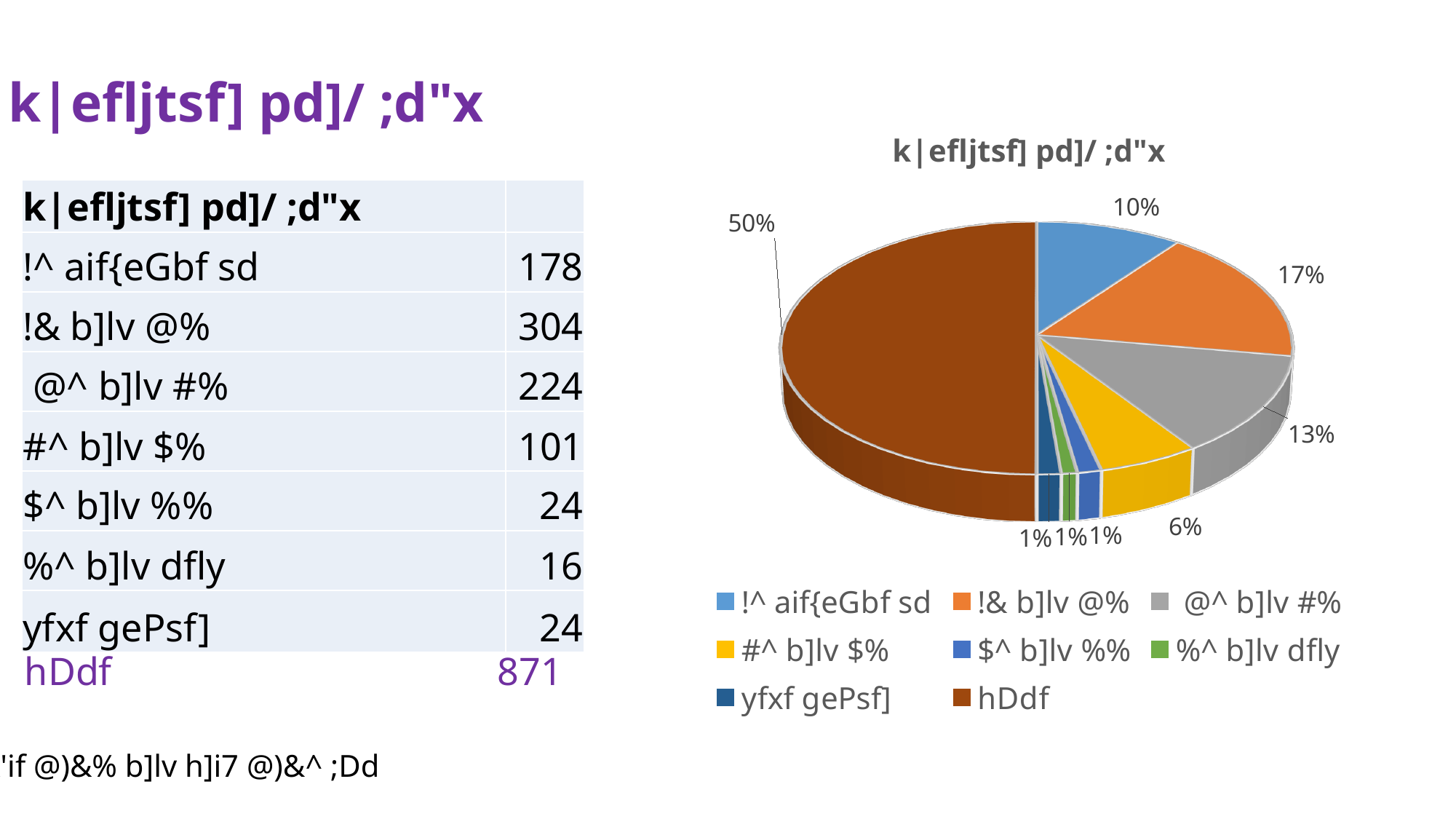
How many slices does the pie chart have? 8 What is the title of the pie chart? k|efljtsf] pd]/ ;d"x Which slice is larger in the pie chart, "!& b]lv @%" or "@^ b]lv #%"? !& b]lv @% Which slice of the pie chart is the largest? hDdf What percentage is shown for the hDdf slice of the pie chart? 50% What percentage is shown for the "!& b]lv @%" slice of the pie chart? 17% What percentage is shown for the "!^ aif{eGbf sd" slice of the pie chart? 10% What kind of chart is shown on the slide? pie chart How many entries does the legend of the pie chart list? 8 What is the difference in percentage points between the "!& b]lv @%" slice and the "!^ aif{eGbf sd" slice? 7% What percentage is shown for the "#^ b]lv $%" slice of the pie chart? 6% What percentage is shown for the "@^ b]lv #%" slice of the pie chart? 13%